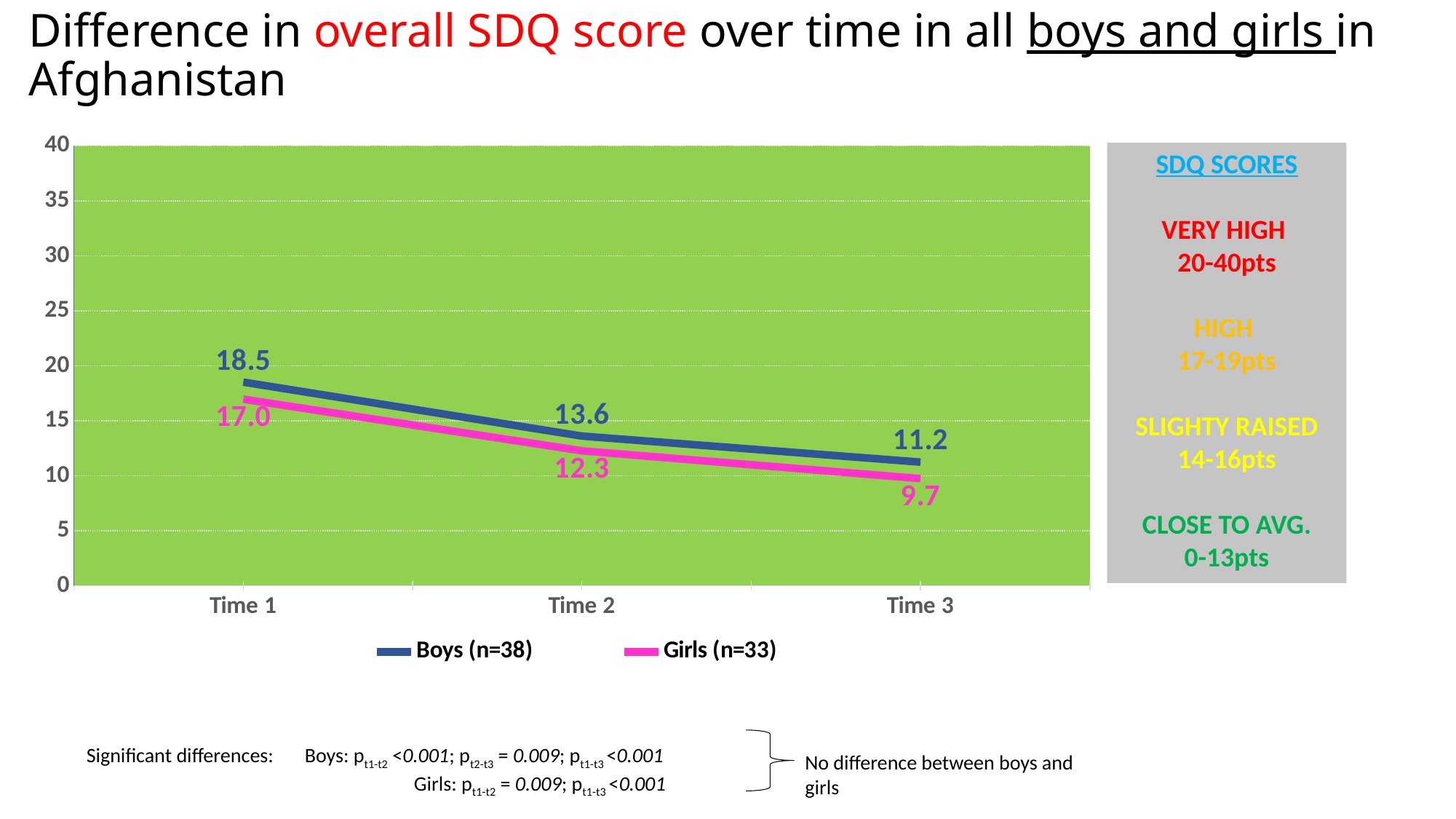
How many series does the legend list? 2 What is the overall SDQ score for Girls (n=33) at Time 3? 9.7 What is the overall SDQ score for Boys (n=38) at Time 3? 11.2 At which time point is the Boys (n=38) score highest? Time 1 Which series has the larger score at Time 2, Boys (n=38) or Girls (n=33)? Boys (n=38) By how much did the Boys (n=38) score fall from Time 1 to Time 3? 7.3 Do the scores rise or fall from Time 1 to Time 3? fall What is the difference between the Boys (n=38) and Girls (n=33) scores at Time 1? 1.5 What is the overall SDQ score for Girls (n=33) at Time 2? 12.3 How many time points are plotted on the x axis? 3 What is the overall SDQ score for Boys (n=38) at Time 1? 18.5 At which time point is the Girls (n=33) score lowest? Time 3